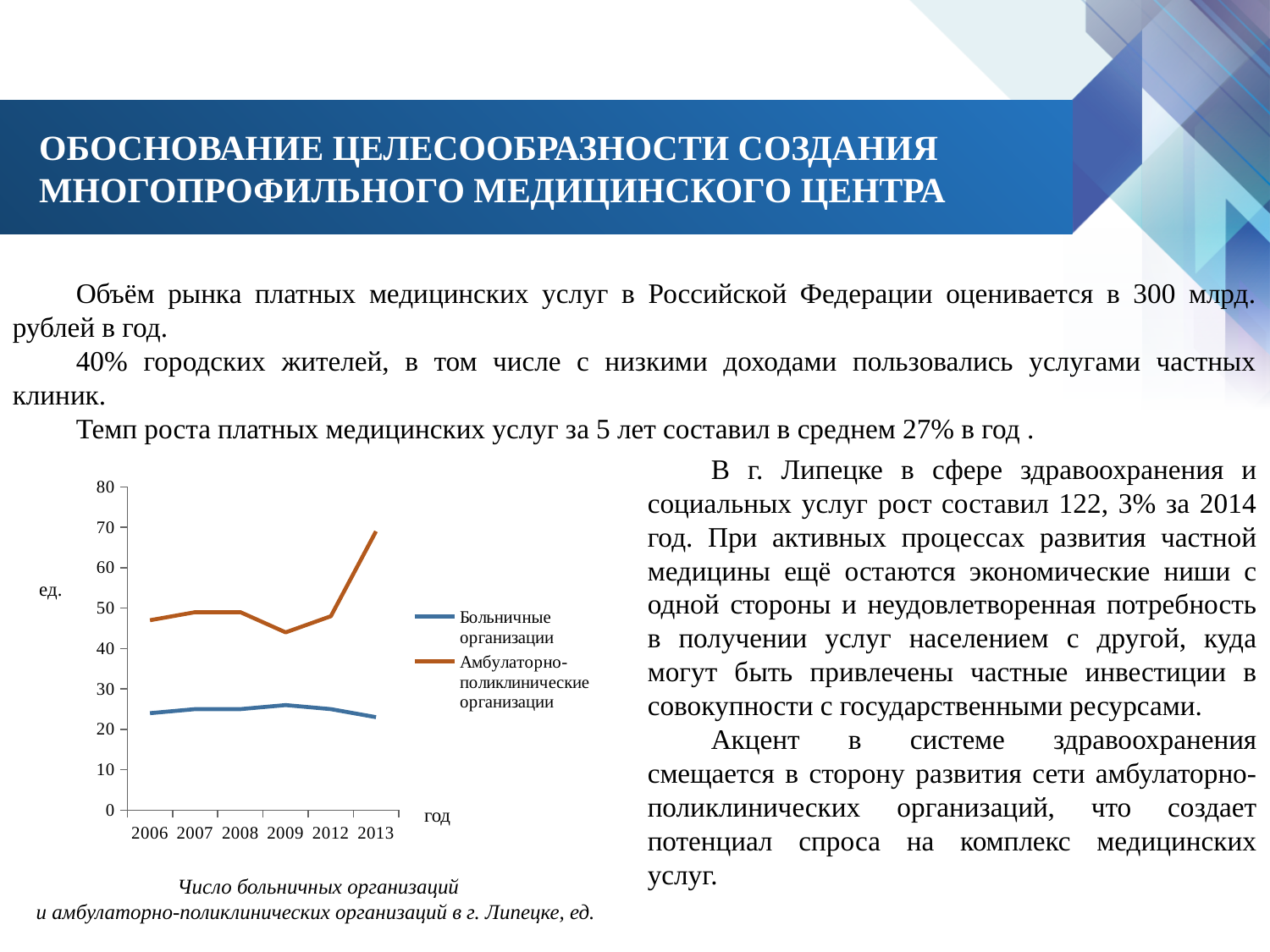
What label is shown on the vertical axis of the chart? ед. How many series does the chart legend list? 2 Does the series 'Амбулаторно-поликлинические организации' rise or fall between 2012 and 2013? rise Is the value for 'Амбулаторно-поликлинические организации' in 2009 greater or less than 50? less Which series has the larger value in 2013, 'Больничные организации' or 'Амбулаторно-поликлинические организации'? Амбулаторно-поликлинические организации Is the value for 'Больничные организации' in 2006 greater or less than 30? less What kind of chart is shown on the slide? line chart In which year does the series 'Амбулаторно-поликлинические организации' reach its lowest value? 2009 Which series is drawn in blue on the chart? Больничные организации Is the value for 'Амбулаторно-поликлинические организации' in 2013 greater or less than 60? greater In which year does the series 'Амбулаторно-поликлинические организации' reach its highest value? 2013 How many years are plotted along the x axis of the chart? 6